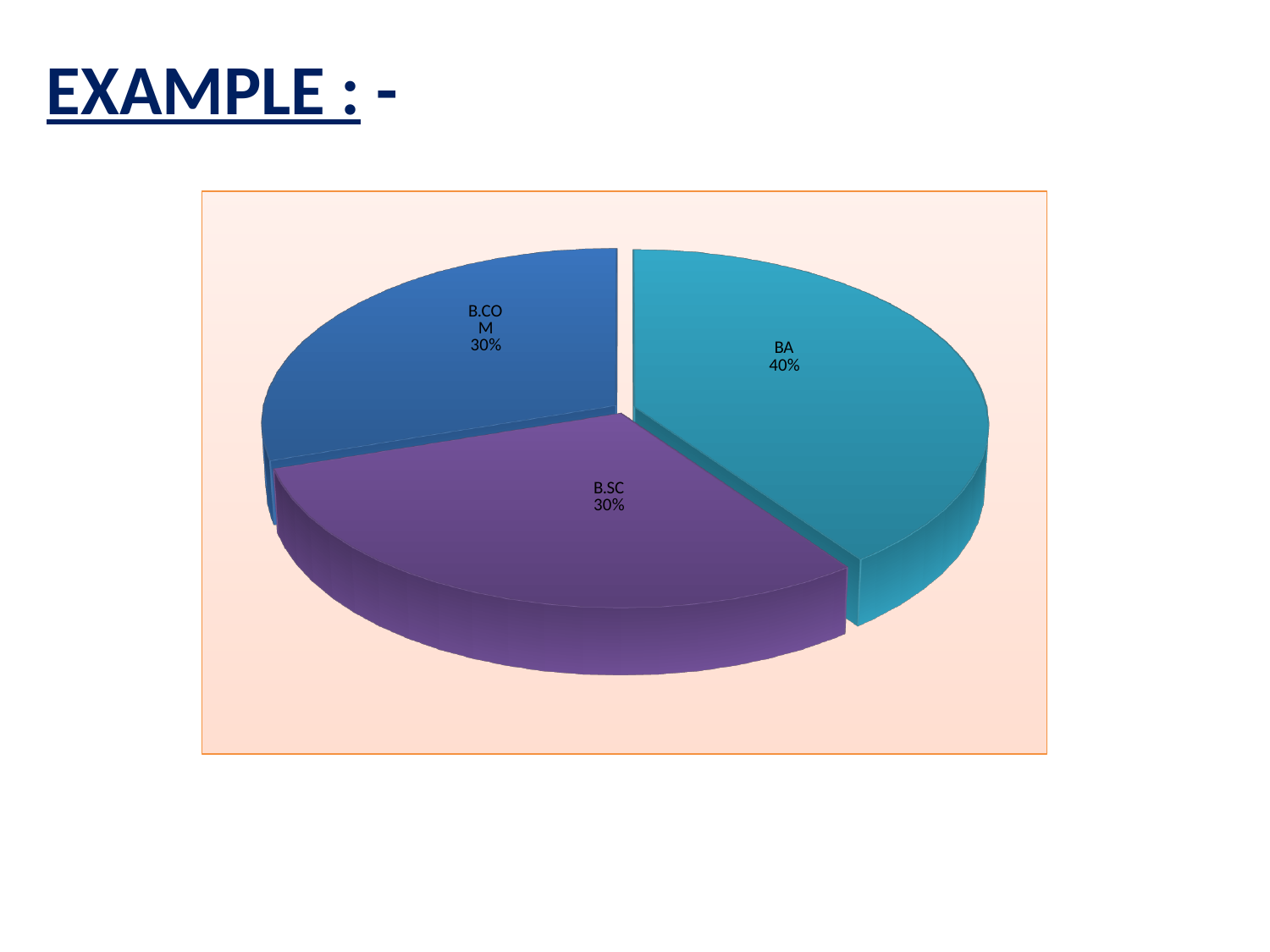
Which is larger, the BA slice or the B.SC slice? BA What share of the pie does B.SC represent? 30% What colour is the BA slice? teal What share of the pie does B.COM represent? 30% Which slice of the pie is the largest? BA What kind of chart is shown on the slide? pie chart How many slices does the pie chart have? 3 Do the B.SC and B.COM slices have the same share? Yes What colour is the B.SC slice? purple What share of the pie does BA represent? 40% What is the difference in percentage points between the BA slice and the B.COM slice? 10%